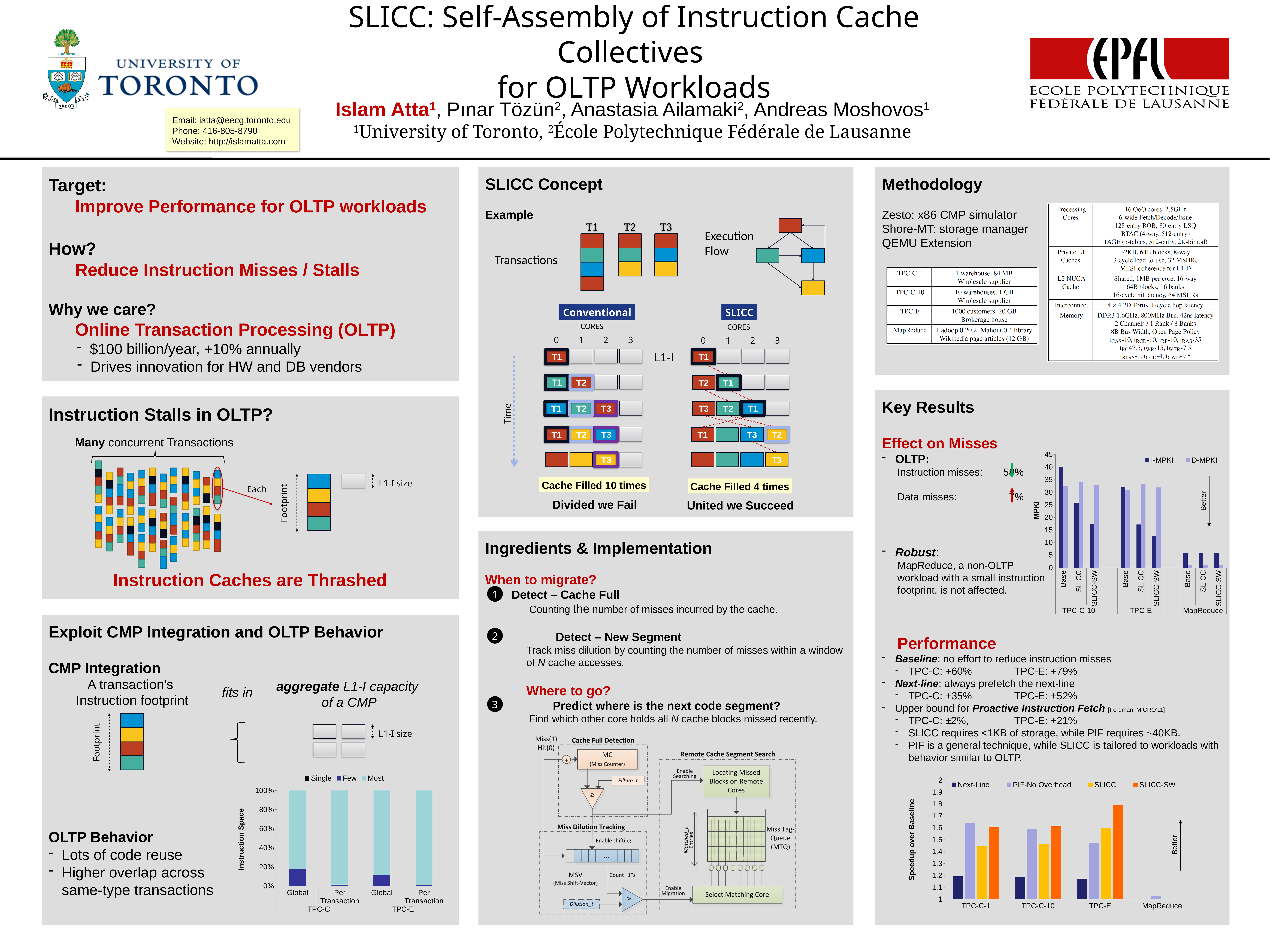
In the Performance chart, which is larger for TPC-E: the SLICC speedup or the PIF-No Overhead speedup? SLICC In the Effect on Misses chart, which workload group has the lowest I-MPKI values? MapReduce What kind of chart is the Effect on Misses chart? bar chart In the Effect on Misses chart, how many series does the legend list? 2 What is the y-axis title of the Performance chart? Speedup over Baseline In the Instruction Space chart (bottom left), how many series does the legend list? 3 In the Effect on Misses chart, which is larger under TPC-C-10: the I-MPKI for Base or for SLICC? Base In the Performance chart, which workload has the highest SLICC-SW speedup? TPC-E In the Performance chart, how many series does the legend list? 4 In the Effect on Misses chart, is the I-MPKI value for SLICC-SW under TPC-E greater or less than 15? less In the Effect on Misses chart, is the I-MPKI value for Base under TPC-C-10 greater or less than 35? greater In the Performance chart, is the Next-Line speedup for TPC-C-1 greater or less than 1.3? less